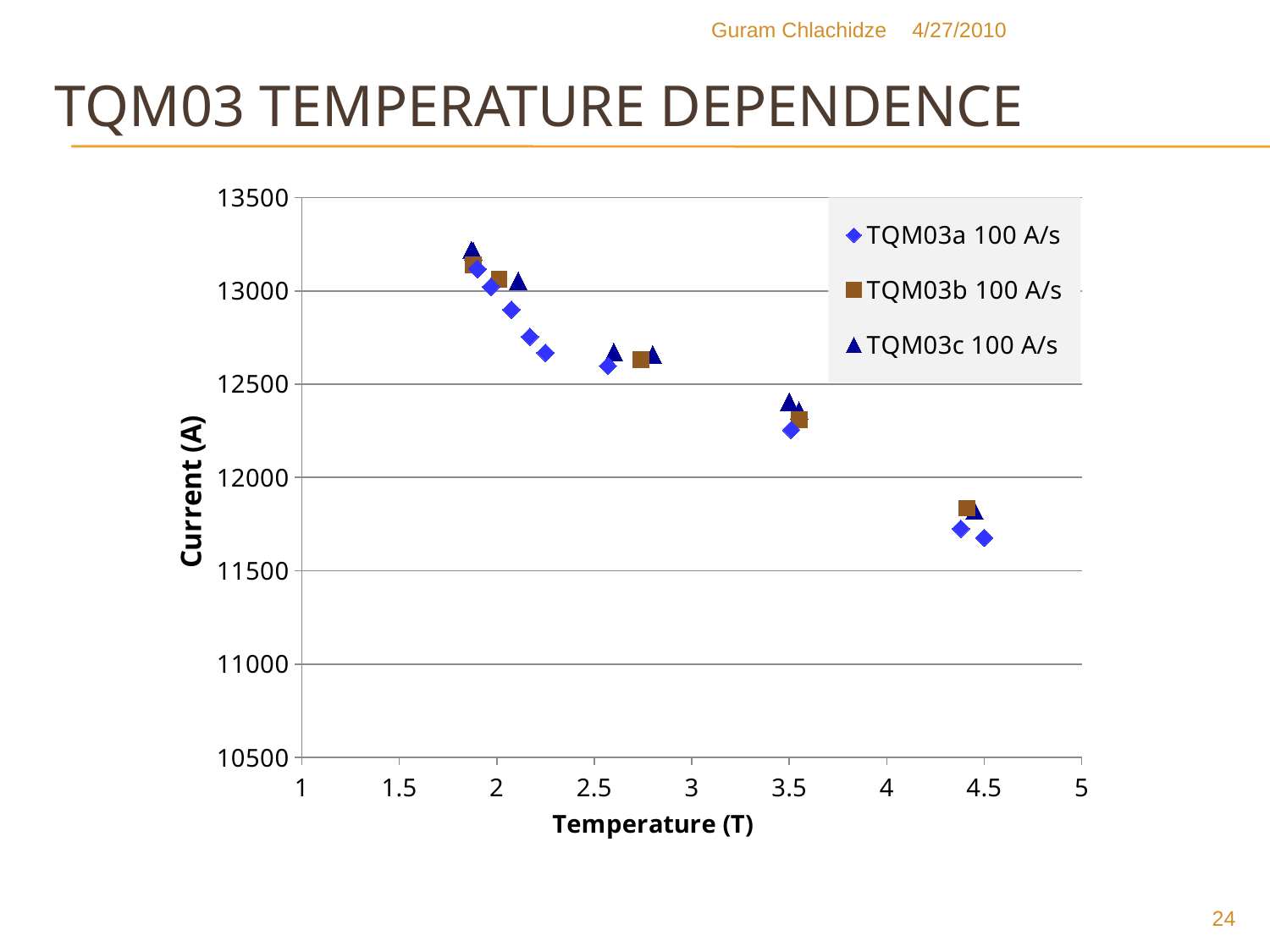
What is the label of the y axis? Current (A) Which series is plotted with triangle markers? TQM03c 100 A/s How many series does the legend list? 3 What kind of chart is shown on the slide? scatter chart Does the current rise or fall as temperature increases along the x axis? fall How many data points are plotted for the TQM03b 100 A/s series? 5 Around 4.4 T, which series has the higher current, TQM03a 100 A/s or TQM03b 100 A/s? TQM03b 100 A/s Is the value for TQM03c 100 A/s at about 1.9 T greater or less than 13000? greater Is the value for TQM03a 100 A/s at about 3.5 T greater or less than 12500? less Is the value for TQM03b 100 A/s at about 4.4 T greater or less than 12000? less